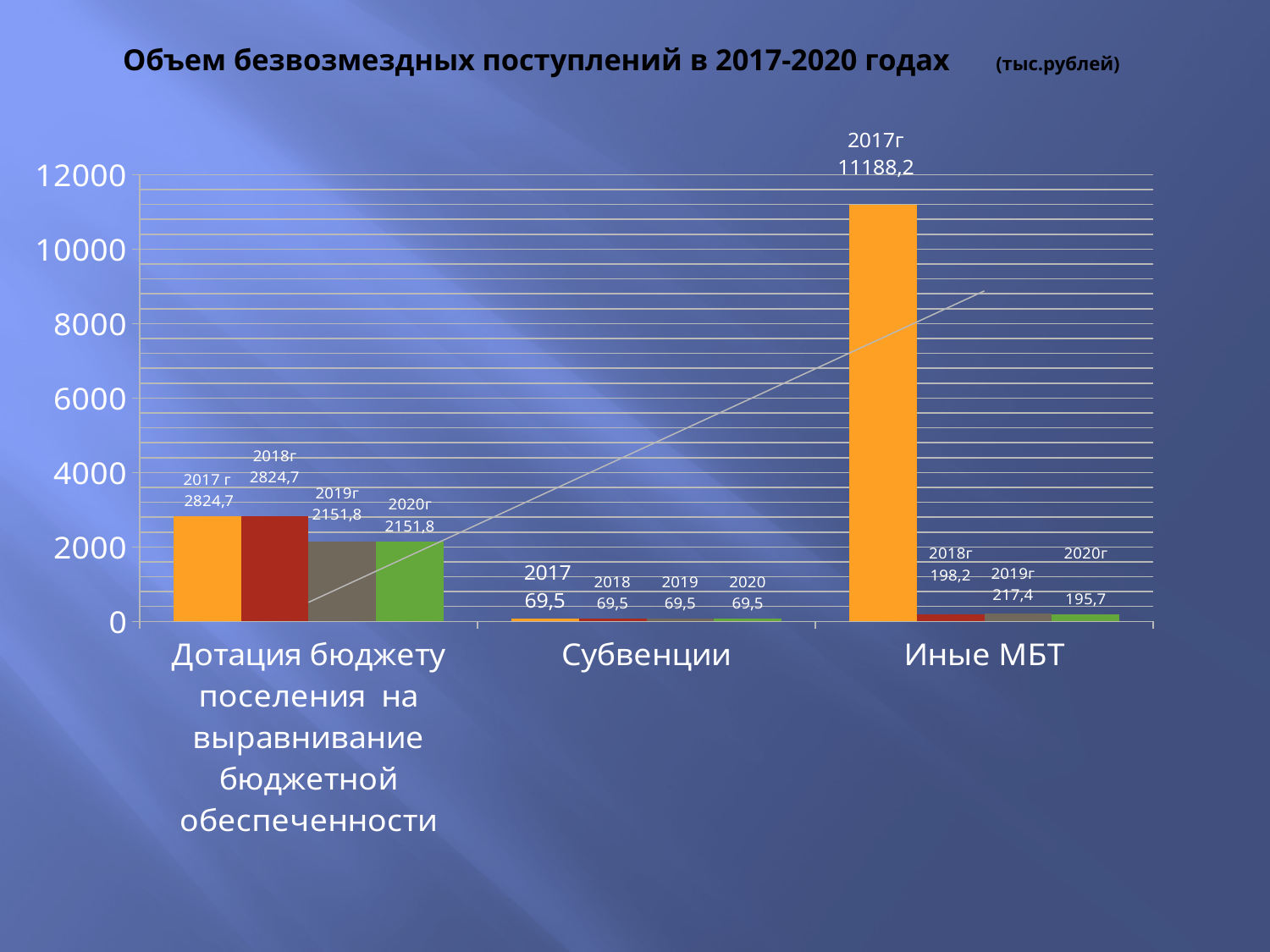
Which category contains the tallest bar on the chart? Иные МБТ Is the 2017 value for Иные МБТ greater or less than 10000? greater What is the value for Иные МБТ in 2020? 195,7 How many categories are shown on the x axis? 3 What is the difference between the 2019 and 2018 values for Иные МБТ? 19,2 What is the value for Дотация бюджету поселения на выравнивание бюджетной обеспеченности in 2019? 2151,8 What is the value for Иные МБТ in 2017? 11188,2 What is the difference between the 2017 and 2020 values for Дотация бюджету поселения на выравнивание бюджетной обеспеченности? 672,9 What kind of chart is shown on the slide? bar chart For Иные МБТ, which year has the larger value, 2019 or 2020? 2019 What is the value for Субвенции in 2018? 69,5 Do the values for Дотация бюджету поселения на выравнивание бюджетной обеспеченности rise or fall from 2017 to 2020? fall